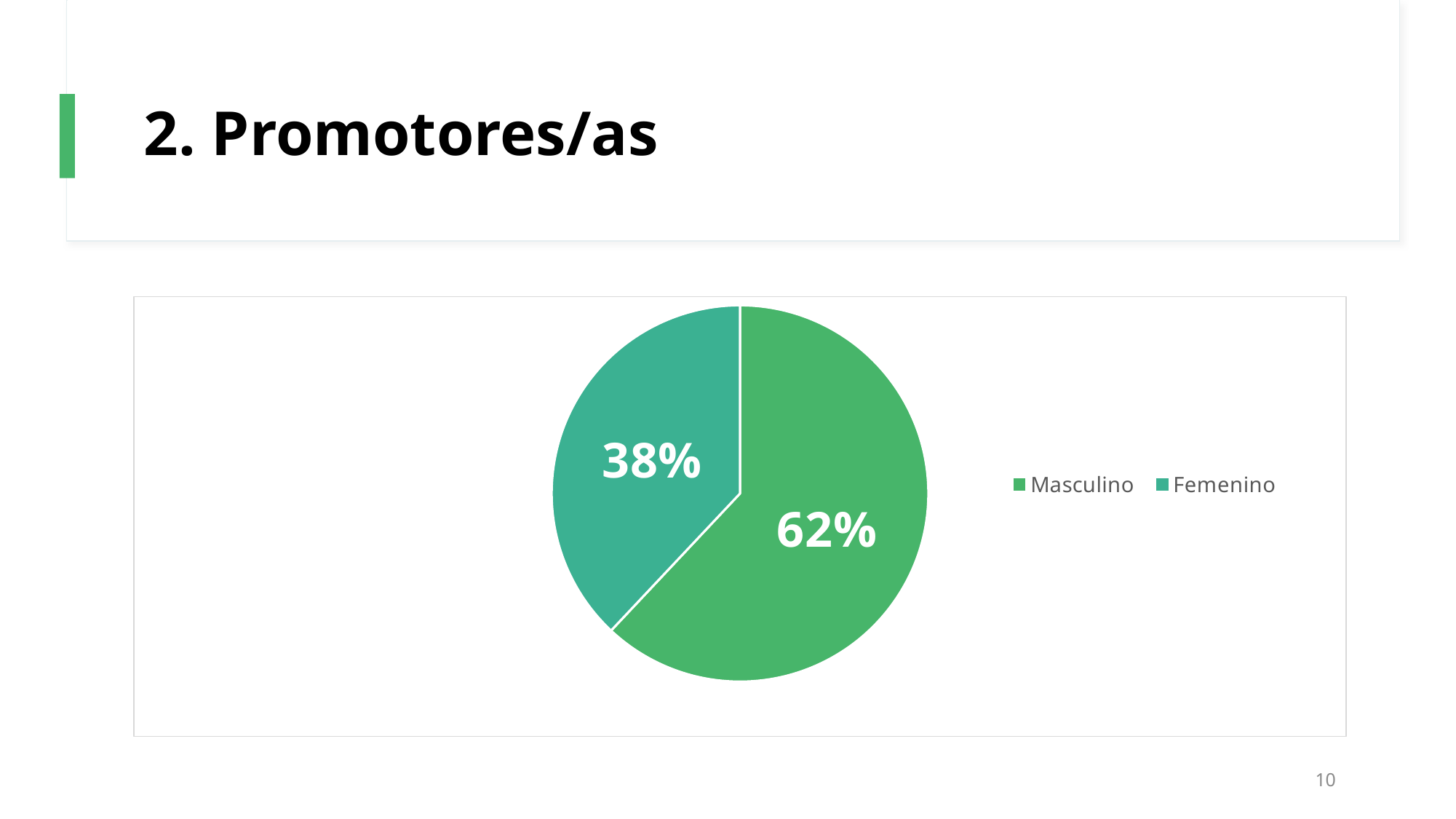
What share of the pie does Masculino represent? 62% What share of the pie does Femenino represent? 38% Which slice is larger, Masculino or Femenino? Masculino Is the value for Masculino greater or less than 50%? greater What type of chart is shown on the slide? pie chart How many entries does the legend list? 2 Which legend entry is shown in the teal colour? Femenino Which category has the largest slice of the pie? Masculino Which category has the smallest slice of the pie? Femenino How many slices does the pie chart have? 2 What is the difference in percentage points between the Masculino and Femenino slices? 24 What is the title of the slide containing the pie chart? 2. Promotores/as